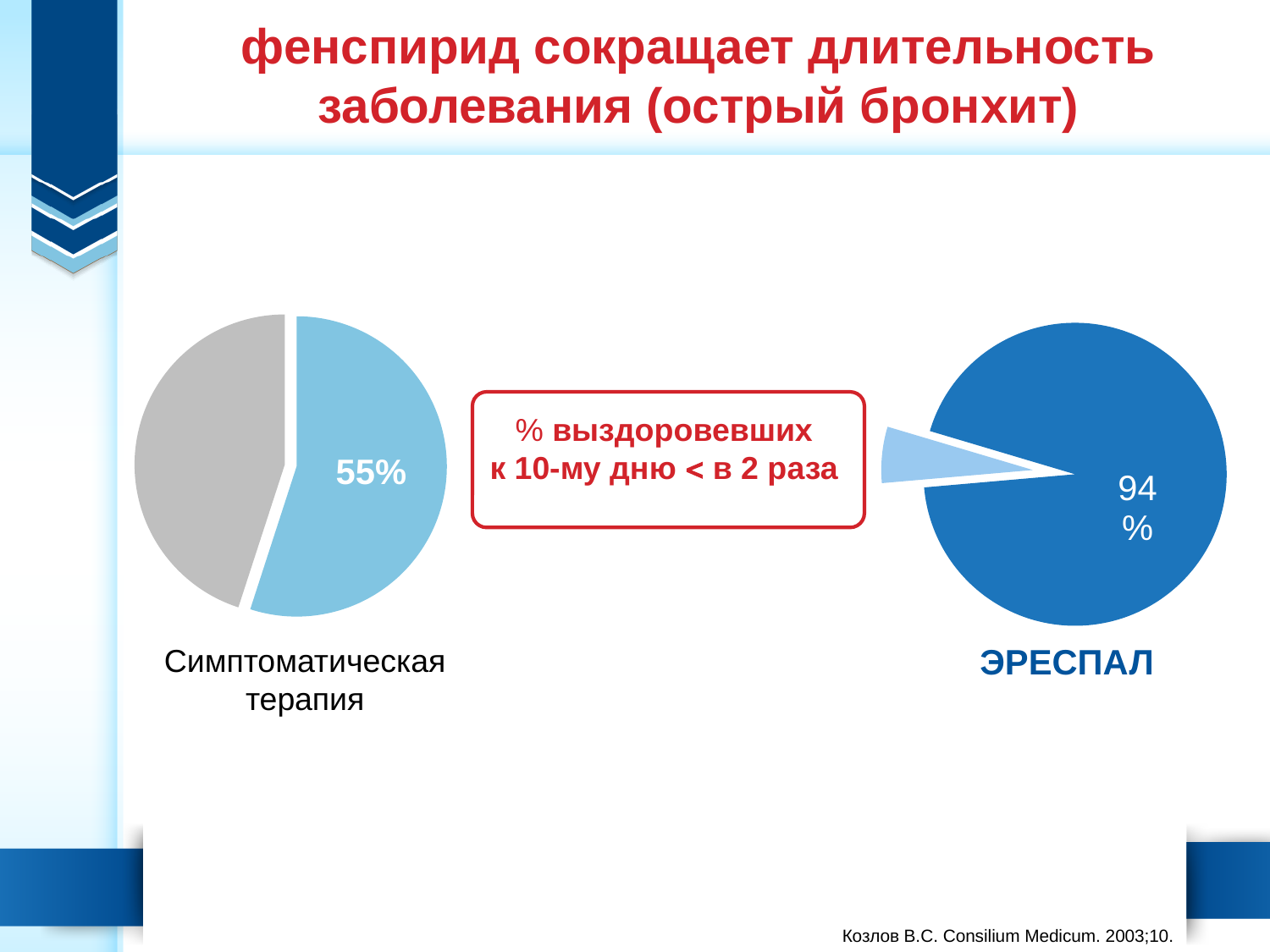
What colour is the unlabelled slice in the pie chart labelled Симптоматическая терапия? Grey In the pie chart labelled Симптоматическая терапия, what value is printed on the blue slice? 55% Which pie chart shows the larger labelled share, Симптоматическая терапия or ЭРЕСПАЛ? ЭРЕСПАЛ What kind of chart is used for Симптоматическая терапия? Pie chart What kind of chart is used for ЭРЕСПАЛ? Pie chart What is the difference in percentage points between the labelled value in the ЭРЕСПАЛ chart and the labelled value in the Симптоматическая терапия chart? 39 In the pie chart labelled ЭРЕСПАЛ, what share of the pie does the dark blue slice represent? 94% How many slices does the pie chart labelled ЭРЕСПАЛ have? 2 How many slices does the pie chart labelled Симптоматическая терапия have? 2 In the pie chart labelled ЭРЕСПАЛ, what value is printed on the dark blue slice? 94% What is the label under the left pie chart? Симптоматическая терапия In the pie chart labelled Симптоматическая терапия, what share of the pie does the light blue slice represent? 55%